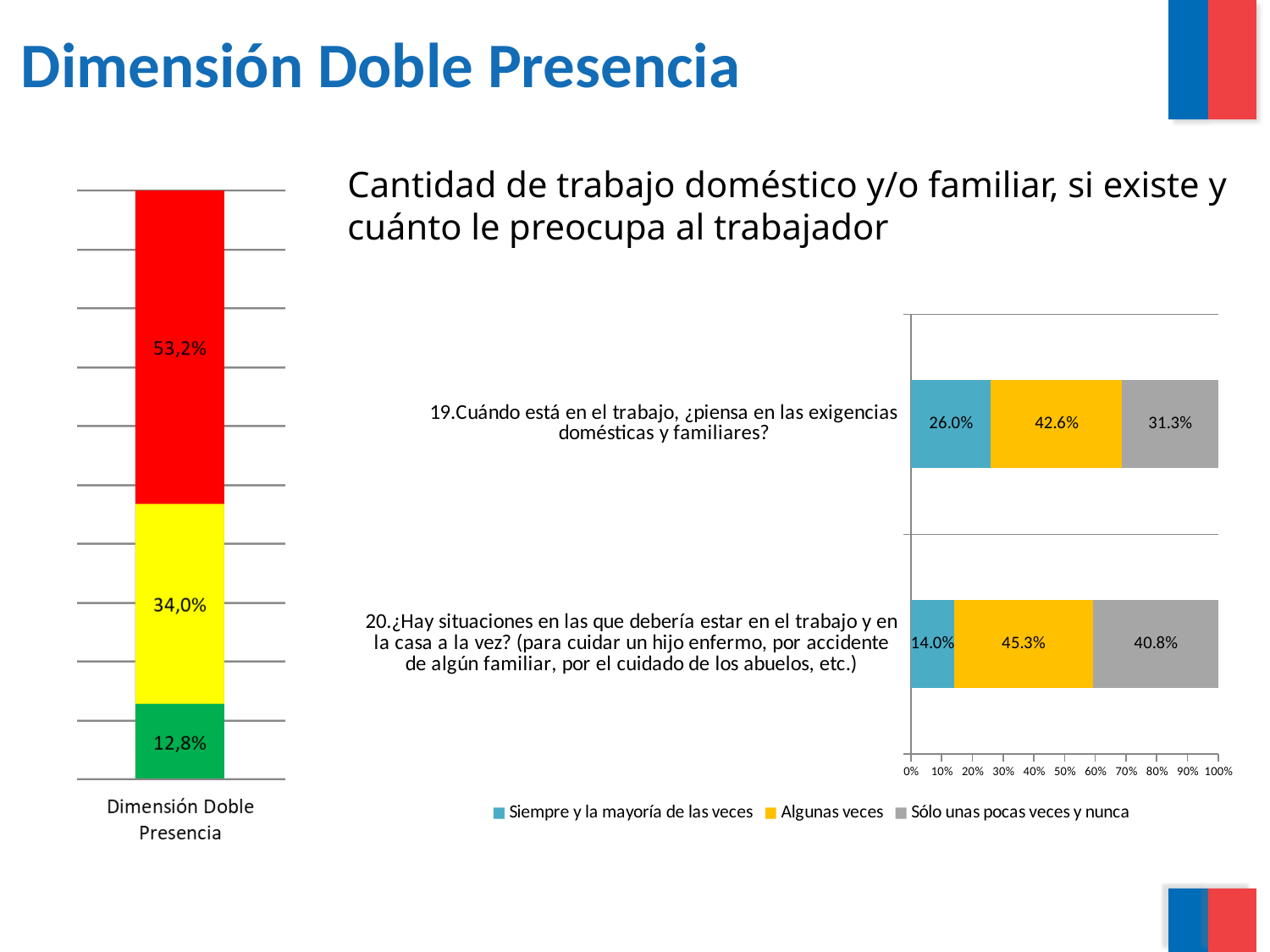
In the right-hand chart, is the 'Sólo unas pocas veces y nunca' value larger for question 19 or question 20? Question 20 In the left-hand chart titled 'Dimensión Doble Presencia', what is the value of the green segment? 12,8% In the right-hand chart, what is the value for 'Algunas veces' for question 19 (¿piensa en las exigencias domésticas y familiares?)? 42.6% In the right-hand chart, which series has the highest value for question 20? Algunas veces In the right-hand chart, what is the value for 'Sólo unas pocas veces y nunca' for question 19? 31.3% How many series does the legend of the right-hand chart list? 3 In the right-hand chart, what is the difference between the 'Siempre y la mayoría de las veces' values for question 19 and question 20? 12.0% In the right-hand chart, what is the value for 'Siempre y la mayoría de las veces' for question 20 (estar en el trabajo y en la casa a la vez)? 14.0% In the right-hand chart, which series has the lowest value for question 19? Siempre y la mayoría de las veces What kind of chart is the right-hand chart? Stacked bar chart In the left-hand chart titled 'Dimensión Doble Presencia', what is the difference between the red and yellow segments? 19,2% In the left-hand chart titled 'Dimensión Doble Presencia', what is the value of the red segment? 53,2%